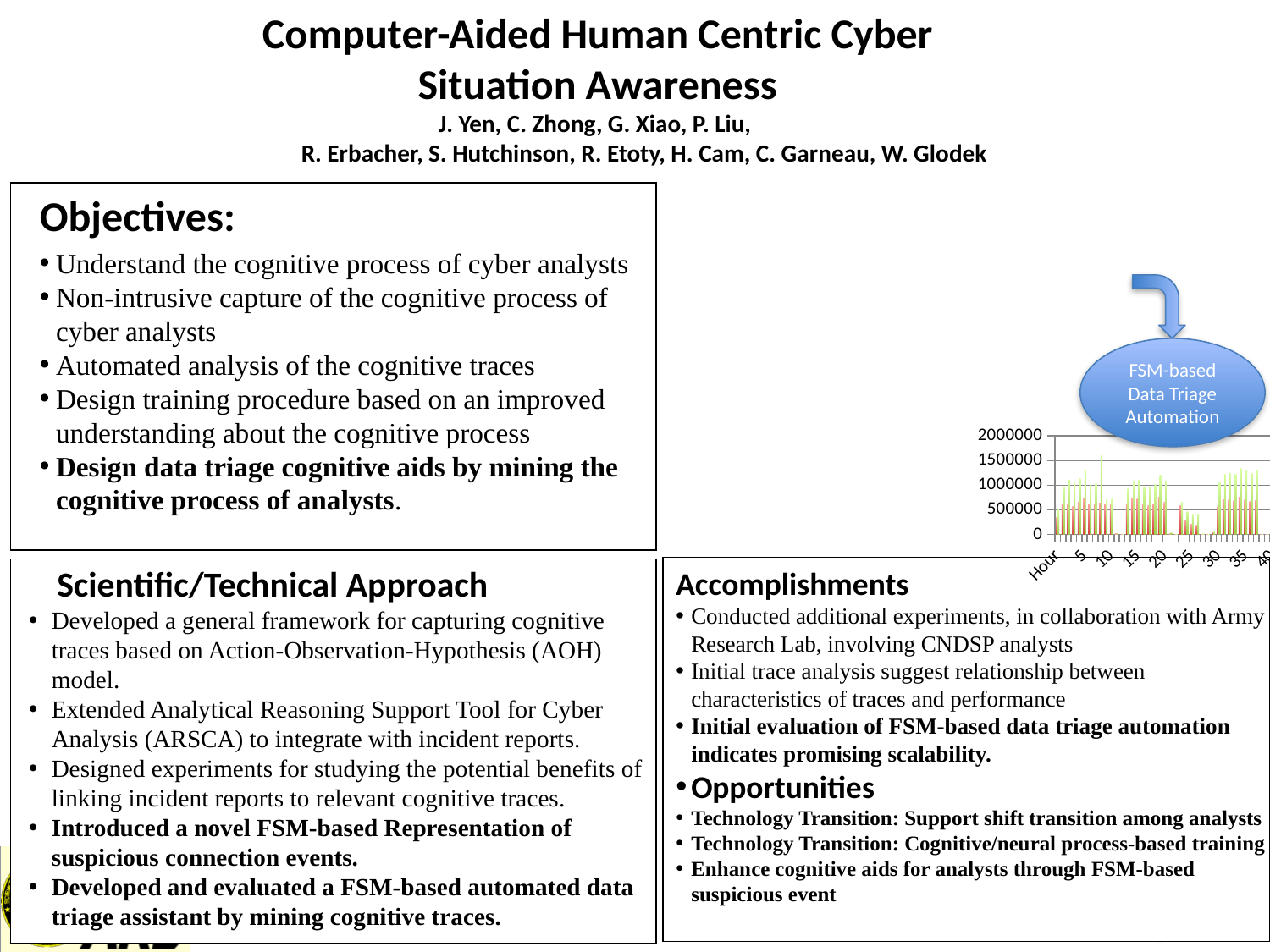
What is the first label shown on the x axis of the bar chart? Hour What is the highest tick value shown on the y axis of the bar chart? 2000000 Is the tallest bar in the chart greater or less than 2000000? less What is the lowest tick value shown on the y axis of the bar chart? 0 What is the last numeric label shown on the x axis of the bar chart? 40 What kind of chart is shown on the right side of the slide? bar chart Is the tallest bar in the chart greater or less than 1000000? greater